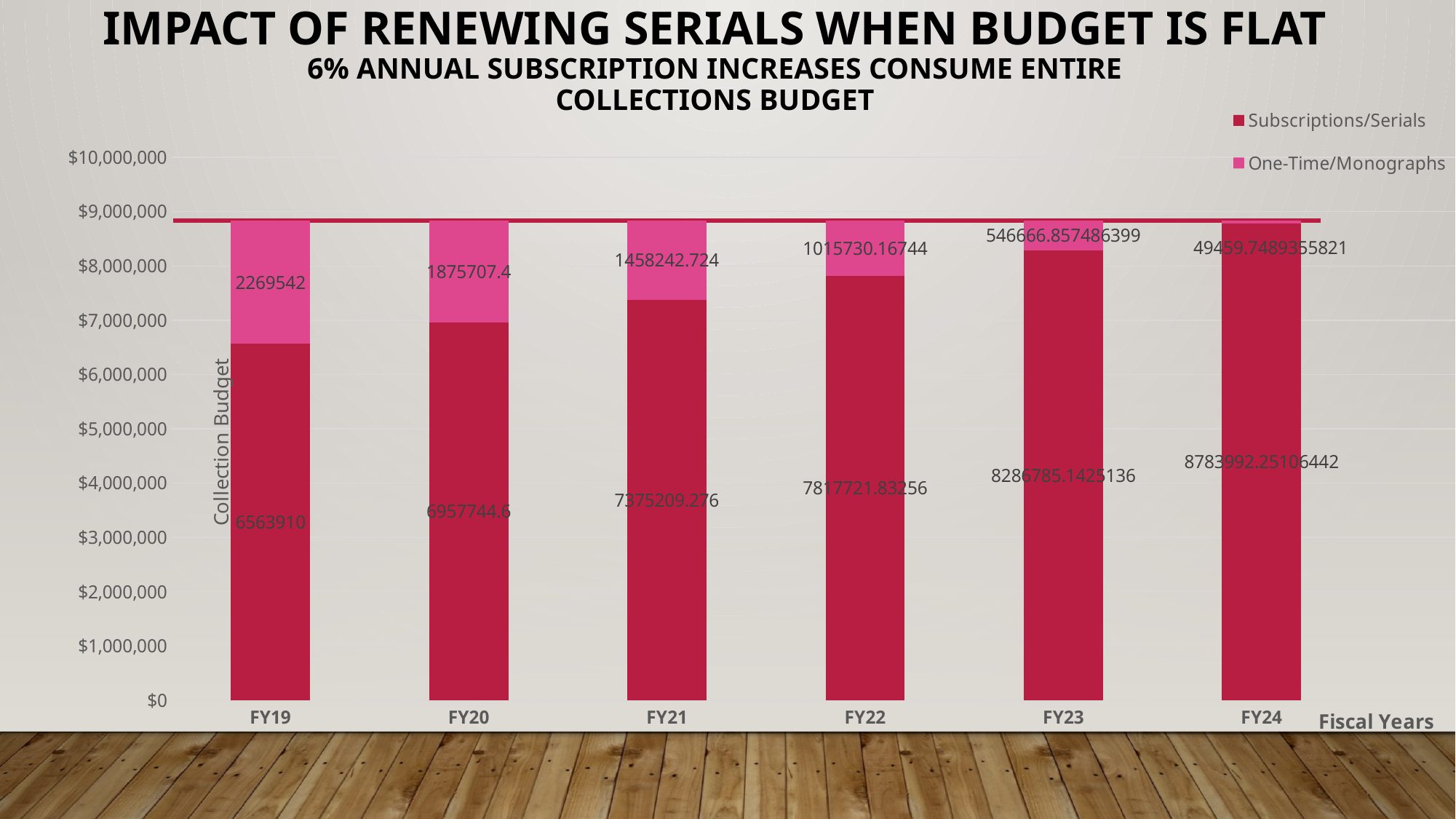
What is the Subscriptions/Serials value for FY24? 8783992.25106442 What type of chart is shown on the slide? stacked bar chart Do the Subscriptions/Serials values rise or fall from FY19 to FY24? rise How many fiscal years are shown on the x axis? 6 Is the Subscriptions/Serials value for FY22 greater or less than $7,000,000? greater Which fiscal year has the highest One-Time/Monographs value? FY19 What is the One-Time/Monographs value for FY21? 1458242.724 How many series does the legend list? 2 What is the total of the stacked bar for FY20? 8833452 What is the Subscriptions/Serials value for FY19? 6563910 Which fiscal year has the lowest Subscriptions/Serials value? FY19 What is the difference between the Subscriptions/Serials and One-Time/Monographs values for FY19? 4294368